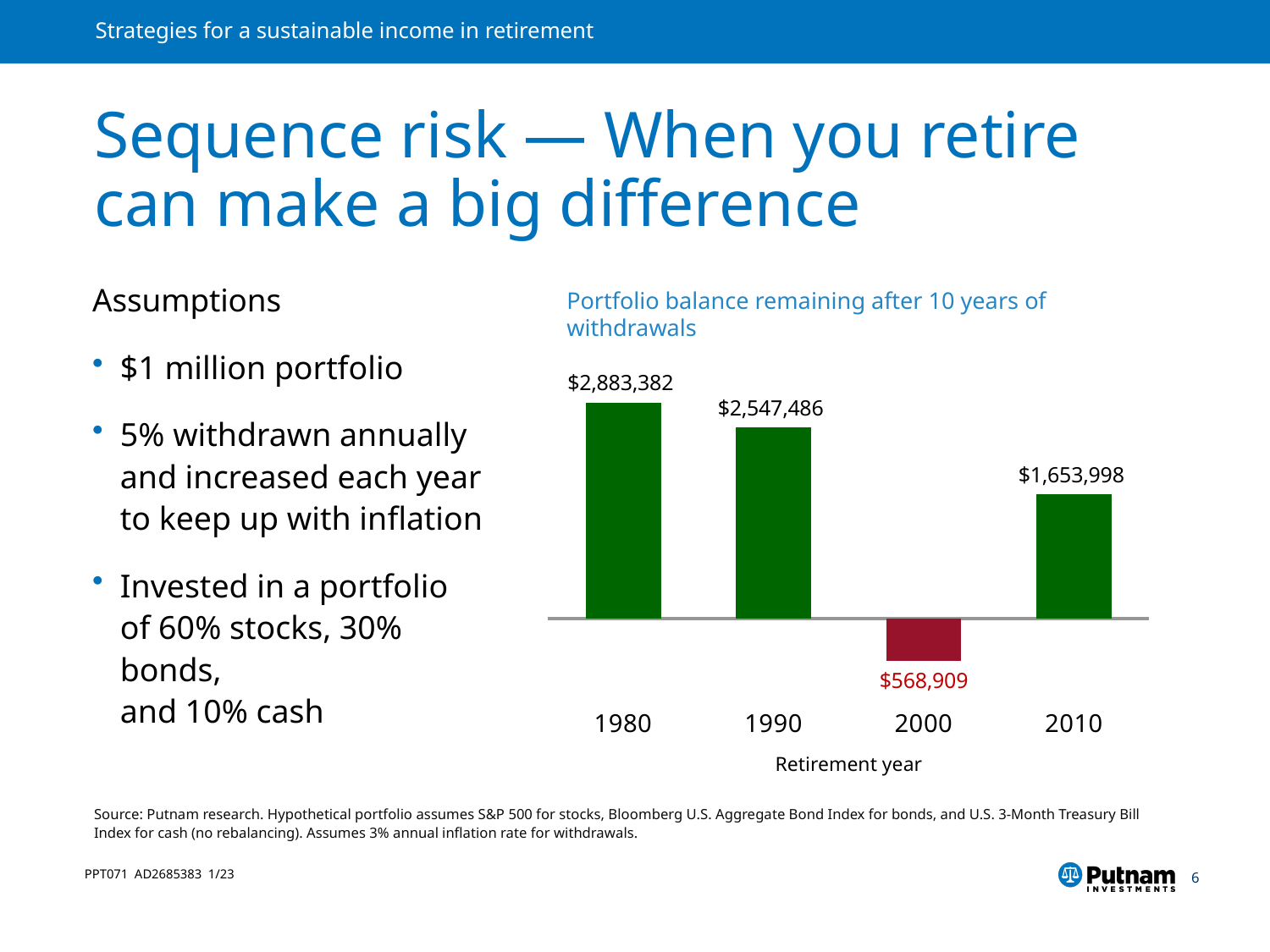
Which retirement year has the lowest portfolio balance remaining after 10 years of withdrawals? 2000 What is the portfolio balance remaining after 10 years of withdrawals for a 1990 retirement year? $2,547,486 What kind of chart is used to show the portfolio balance remaining after 10 years of withdrawals? Bar chart What is the label on the x axis of the chart? Retirement year What is the difference between the portfolio balances for the 1990 and 2010 retirement years? $893,488 What value is labeled on the bar for the 2000 retirement year? $568,909 What is the portfolio balance remaining after 10 years of withdrawals for a 1980 retirement year? $2,883,382 Which retirement year has a larger remaining portfolio balance, 1990 or 2010? 1990 Which retirement year has the highest portfolio balance remaining after 10 years of withdrawals? 1980 How many retirement years are shown in the chart? 4 What is the difference between the portfolio balances for the 1980 and 1990 retirement years? $335,896 What is the portfolio balance remaining after 10 years of withdrawals for a 2010 retirement year? $1,653,998